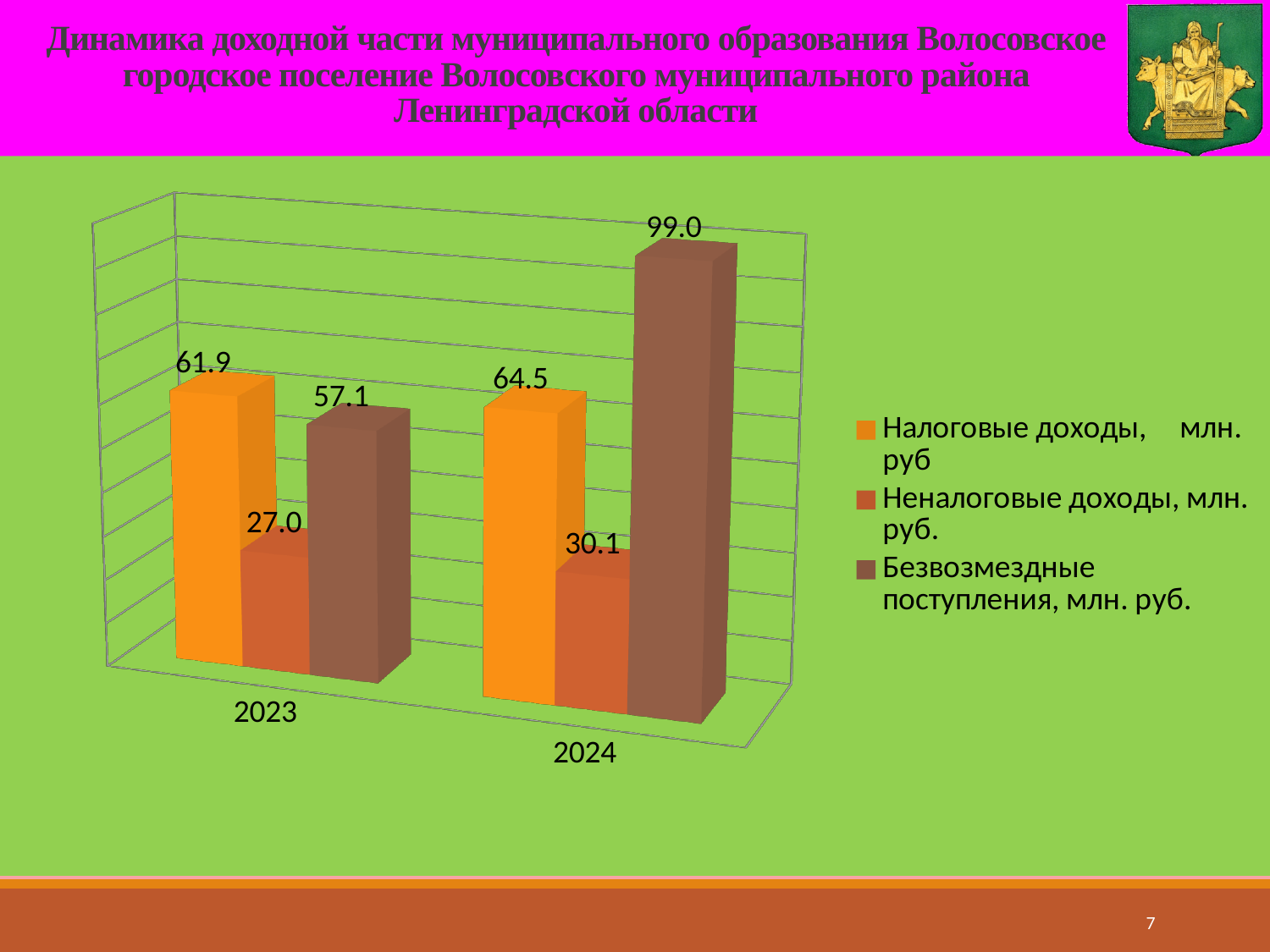
What is the value of Неналоговые доходы for 2024? 30.1 Do the values of Налоговые доходы rise or fall from 2023 to 2024? Rise What is the value of Безвозмездные поступления for 2024? 99.0 How many years are shown on the x axis? 2 What is the value of Неналоговые доходы for 2023? 27.0 What kind of chart is shown on the slide? Bar chart What is the difference between Безвозмездные поступления in 2024 and in 2023? 41.9 Which series has the lowest value in 2023? Неналоговые доходы Which series has the highest value in 2024? Безвозмездные поступления Which is larger in 2023: Налоговые доходы or Безвозмездные поступления? Налоговые доходы What is the value of Налоговые доходы for 2023? 61.9 How many series does the legend list? 3